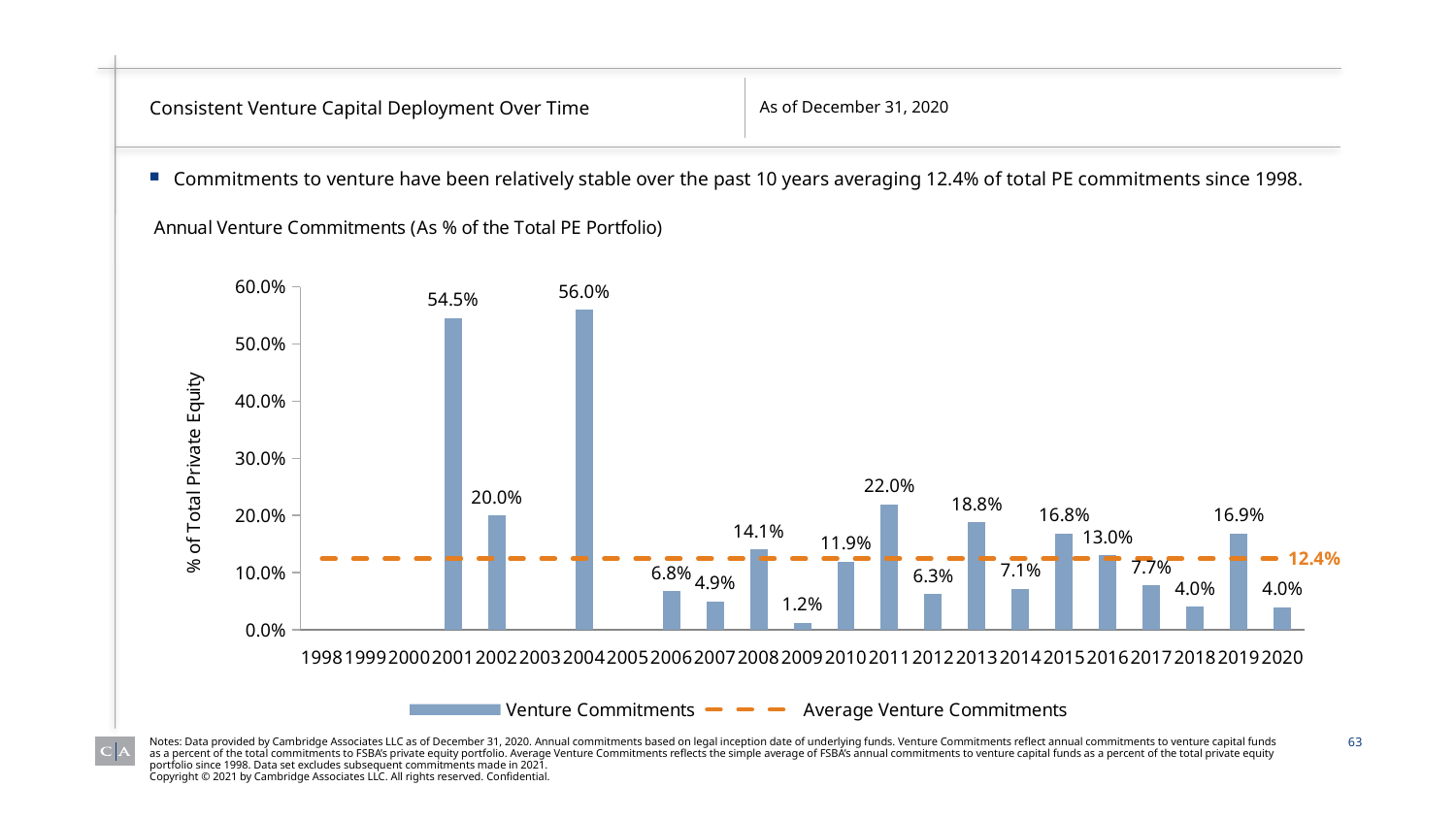
What is the value for 2011 in the Annual Venture Commitments chart? 22.0% What is the difference between the Venture Commitments values for 2004 and 2001? 1.5% What is the value for 2004 in the Annual Venture Commitments chart? 56.0% What kind of chart is used to show the Annual Venture Commitments? Combination bar and line chart What value does the dashed Average Venture Commitments line show? 12.4% Which year has the highest Venture Commitments value? 2004 Among the years with a labeled bar, which year has the lowest Venture Commitments value? 2009 What is the label of the y axis in the Annual Venture Commitments chart? % of Total Private Equity What is the difference between the Venture Commitments values for 2013 and 2012? 12.5% How many series does the legend list? 2 Is the Venture Commitments value for 2002 greater or less than 10.0%? greater Which is larger, the Venture Commitments value for 2015 or for 2019? 2019